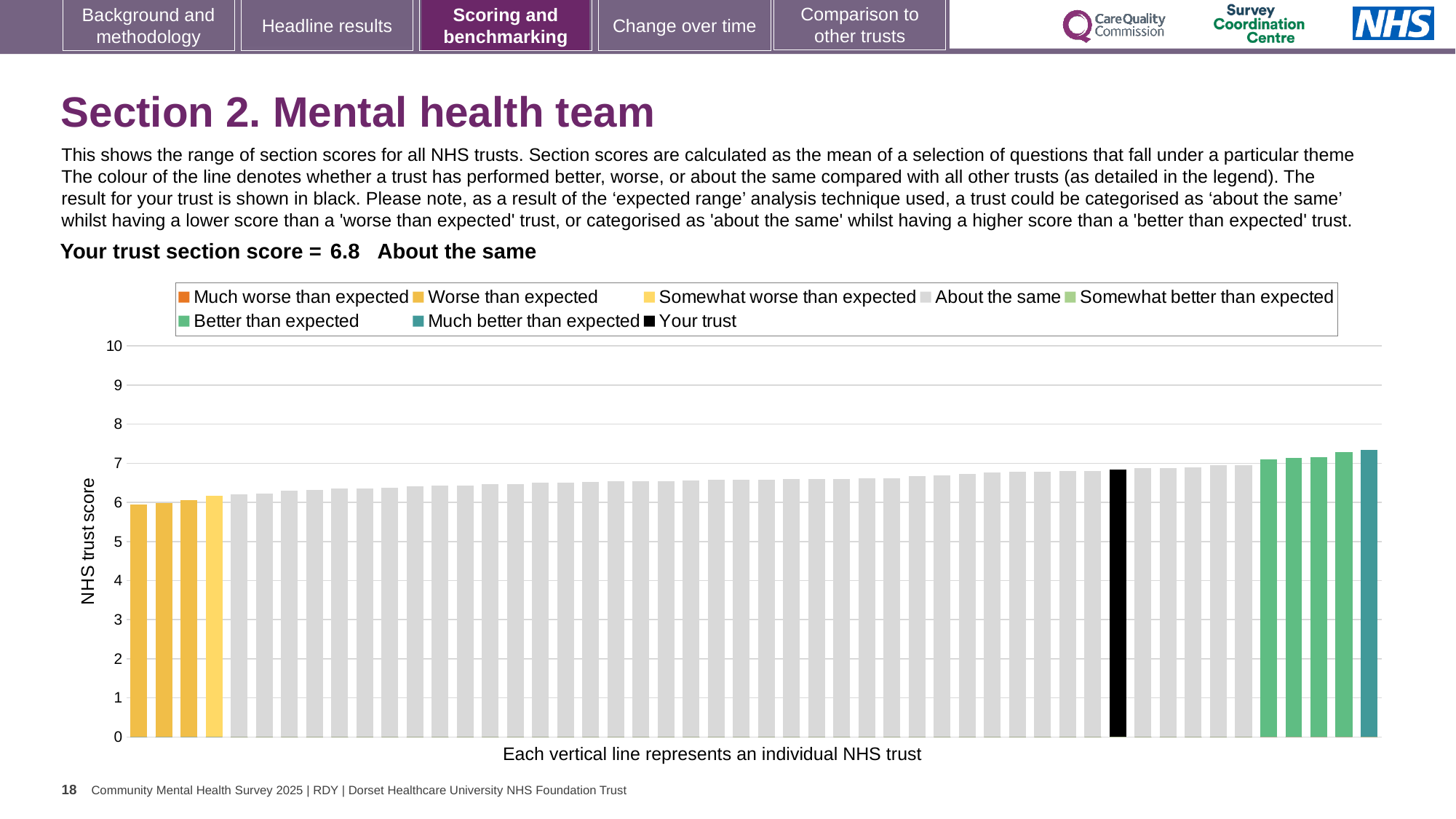
Is the value for your trust greater or less than 6? greater Is your trust's bar higher or lower than the tallest bar on the chart? lower What is the label on the y axis of the chart? NHS trust score Which legend category does the highest bar on the chart belong to? Much better than expected What kind of chart is shown on the slide? bar chart Is the value of the lowest bar greater or less than 5? greater Is the value of the highest bar greater or less than 7? greater Do the bar values rise or fall from left to right along the x axis? rise How many entries does the chart legend list? 8 What is the section score for your trust? 6.8 Which performance category is your trust placed in for this section? About the same